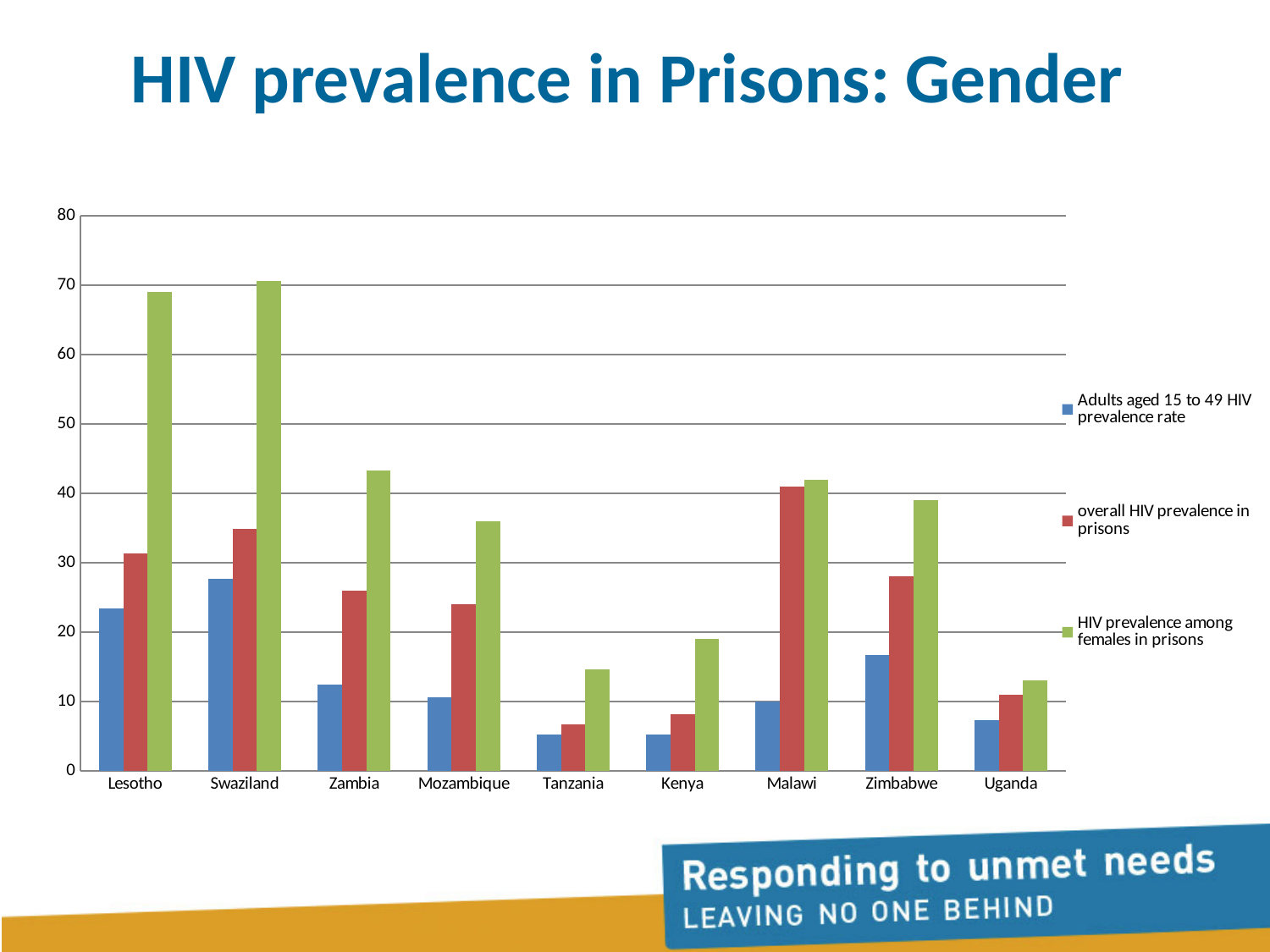
How many series does the chart's legend list? 3 Is the HIV prevalence among females in prisons for Lesotho greater or less than 60? greater What kind of chart is shown on the slide? bar chart Is the adults aged 15 to 49 HIV prevalence rate for Kenya greater or less than 10? less Which is larger: the adults aged 15 to 49 HIV prevalence rate for Lesotho or for Zambia? Lesotho Which country has the highest overall HIV prevalence in prisons? Malawi What colour represents HIV prevalence among females in prisons in the chart? green How many countries are shown on the x axis of the chart? 9 Which country has the highest adults aged 15 to 49 HIV prevalence rate? Swaziland Is the HIV prevalence among females in prisons for Tanzania greater or less than 20? less Which is larger: the overall HIV prevalence in prisons for Malawi or for Zimbabwe? Malawi